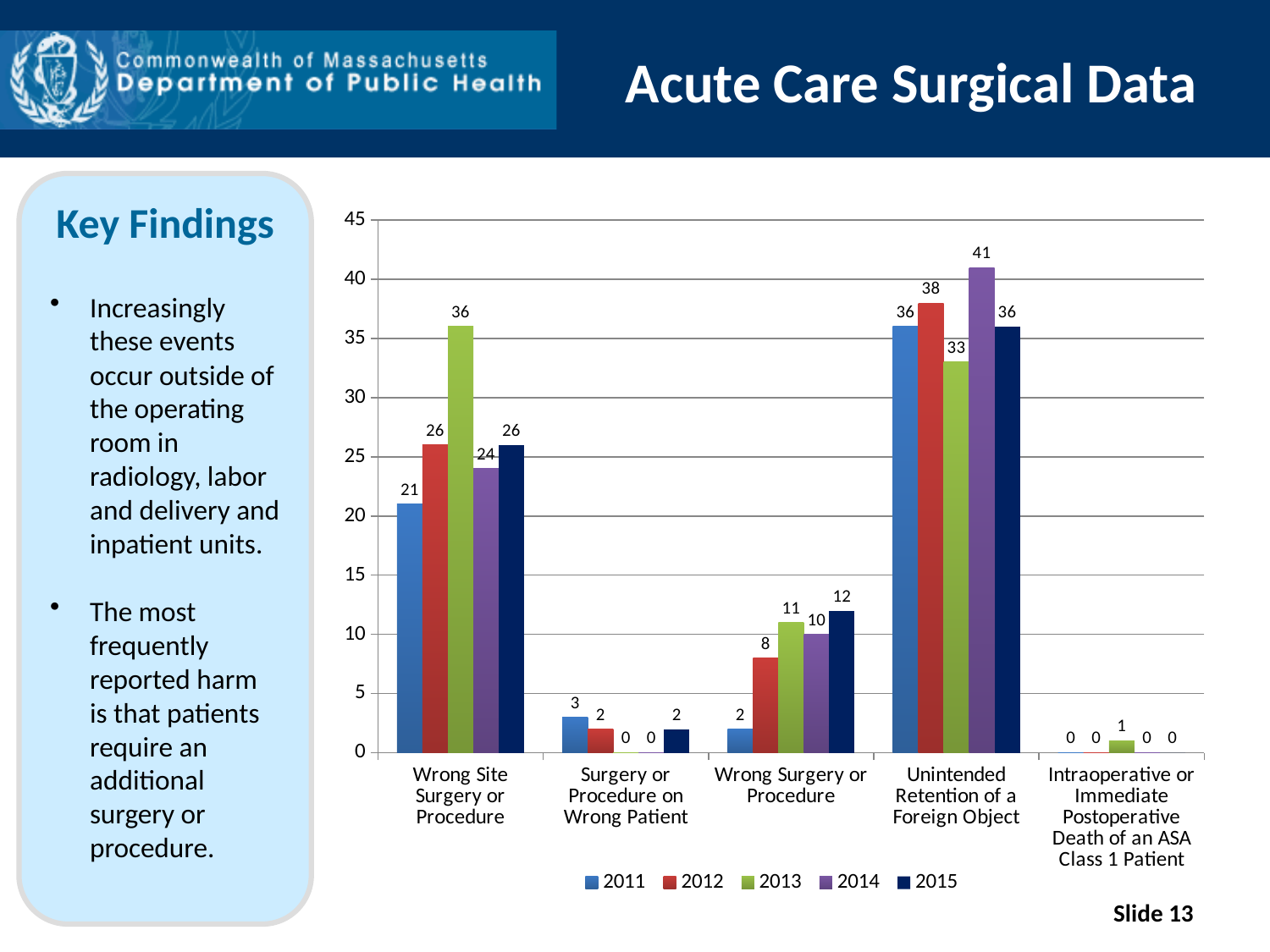
How many event categories are shown on the x axis? 5 What is the only non-zero value in the Intraoperative or Immediate Postoperative Death of an ASA Class 1 Patient category, and for which year? 1, 2013 Is the 2012 value for Unintended Retention of a Foreign Object greater or less than 35? greater What is the difference between the 2013 and 2011 values for Wrong Site Surgery or Procedure? 15 How many series does the legend list? 5 Which year has the lowest value in the Wrong Site Surgery or Procedure category? 2011 Which is larger for 2015: Wrong Site Surgery or Procedure or Wrong Surgery or Procedure? Wrong Site Surgery or Procedure What is the value for 2012 in the Wrong Surgery or Procedure category? 8 What is the value for 2014 in the Unintended Retention of a Foreign Object category? 41 Which year has the highest value in the Unintended Retention of a Foreign Object category? 2014 What kind of chart is shown on the slide? Bar chart What is the value for 2013 in the Wrong Site Surgery or Procedure category? 36